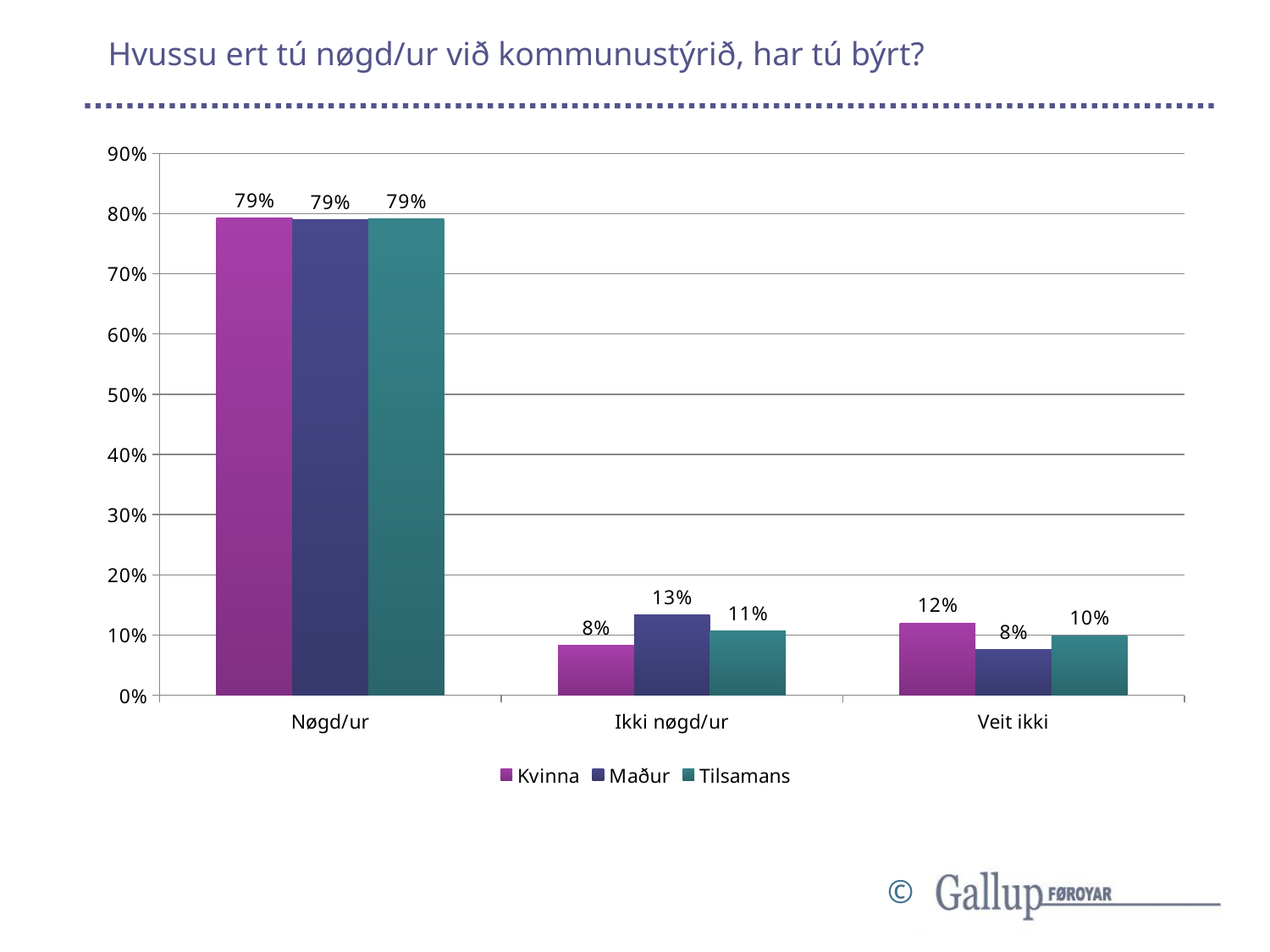
Is the value for Tilsamans in the Ikki nøgd/ur category greater or less than 20%? less What kind of chart is shown on the slide? bar chart What is the difference between the Maður and Kvinna values in the Ikki nøgd/ur category? 5% What is the value for Maður in the Ikki nøgd/ur category? 13% How many series does the legend list? 3 Which category has the highest value for the Tilsamans series? Nøgd/ur In the Veit ikki category, which is larger: the Kvinna value or the Maður value? Kvinna What is the value for Kvinna in the Veit ikki category? 12% Which category has the lowest value for the Maður series? Veit ikki What is the value for Tilsamans in the Veit ikki category? 10% How many categories are shown on the x axis? 3 What is the value for Kvinna in the Nøgd/ur category? 79%